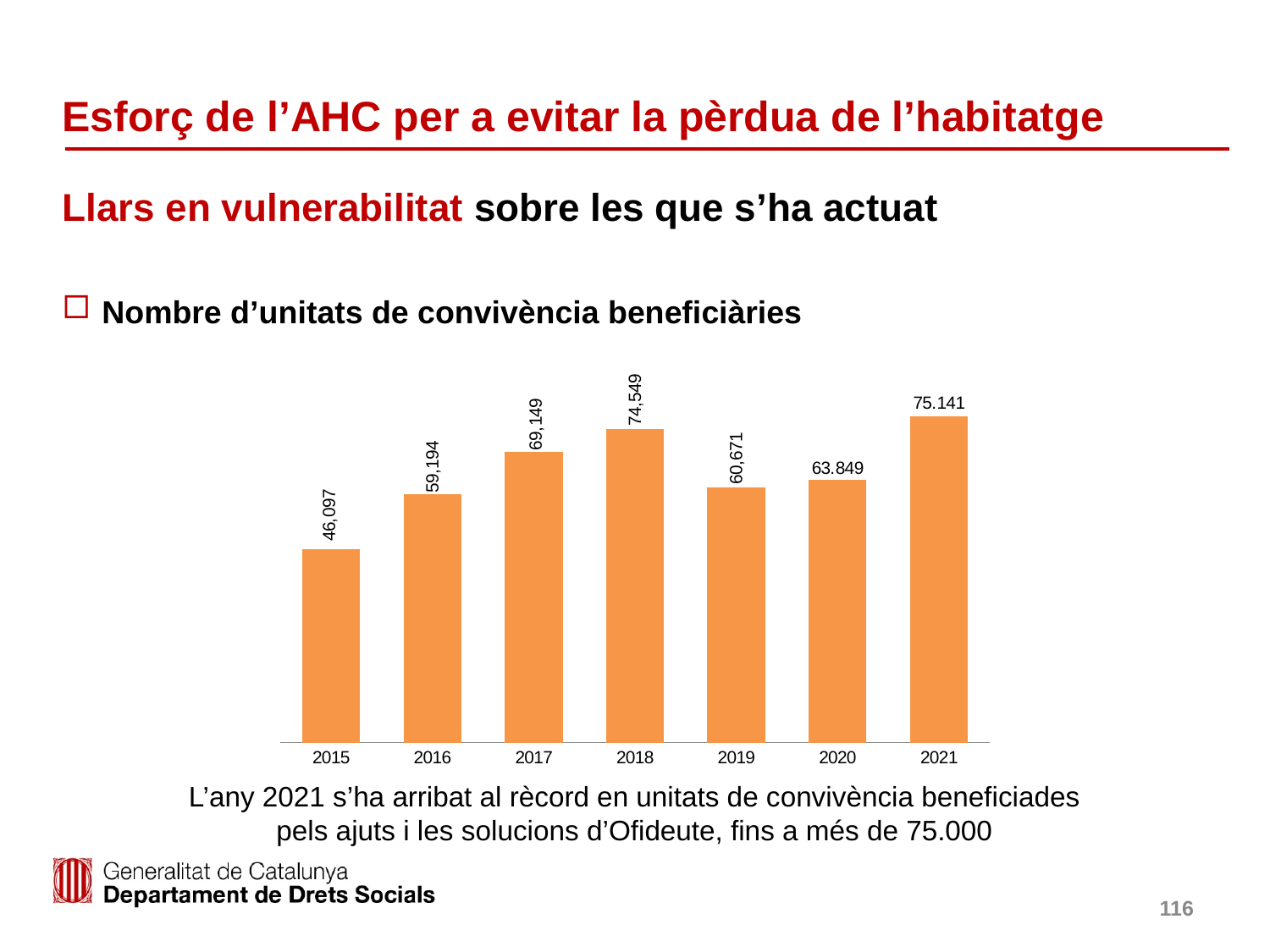
Which year has the highest number of unitats de convivència beneficiàries? 2021 Do the values rise or fall from 2015 to 2018? Rise What kind of chart is shown on the slide? Bar chart What is the difference between the values for 2021 and 2018? 592 What is the value for 2018 in the chart? 74,549 What is the value for 2021 in the chart? 75.141 What is the value for 2020 in the chart? 63.849 What is the difference between the values for 2018 and 2015? 28,452 Which year has the lowest number of unitats de convivència beneficiàries? 2015 Which year has a larger value, 2017 or 2019? 2017 How many years are shown in the chart? 7 What is the value for 2015 in the chart of Nombre d'unitats de convivència beneficiàries? 46,097